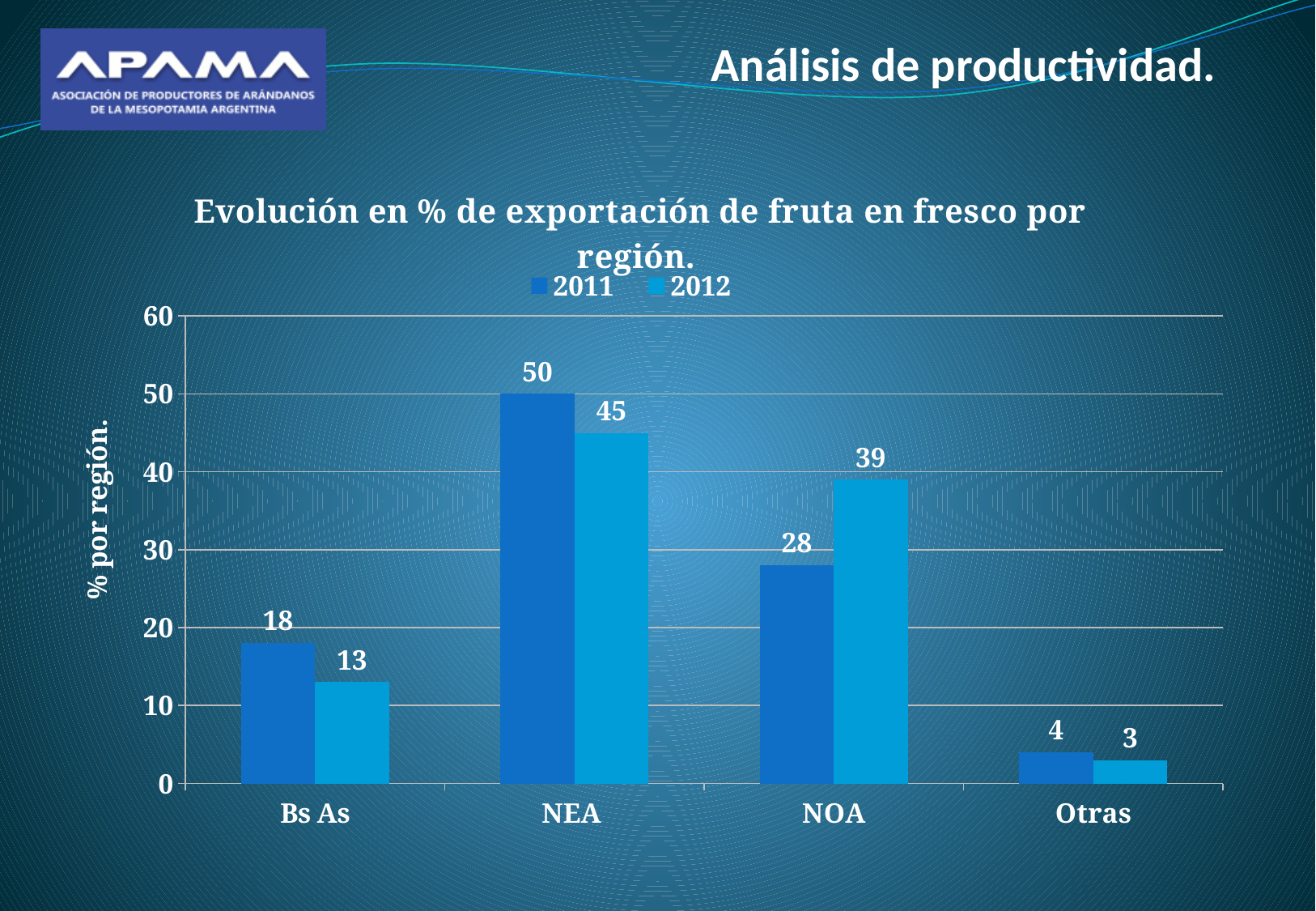
What is the difference between the NEA and Bs As values in 2011? 32 Which region has the lowest value in 2011? Otras What kind of chart is shown on the slide? Bar chart Which region has the highest value in 2012? NEA What is the value for Bs As in 2012? 13 What is the value for NOA in 2012? 39 What is the value for NEA in 2011? 50 What is the label of the y axis? % por región. How many series does the legend list? 2 How many regions are shown on the x axis? 4 What is the difference between the 2011 and 2012 values for NOA? 11 Which is larger for Bs As, the 2011 value or the 2012 value? 2011